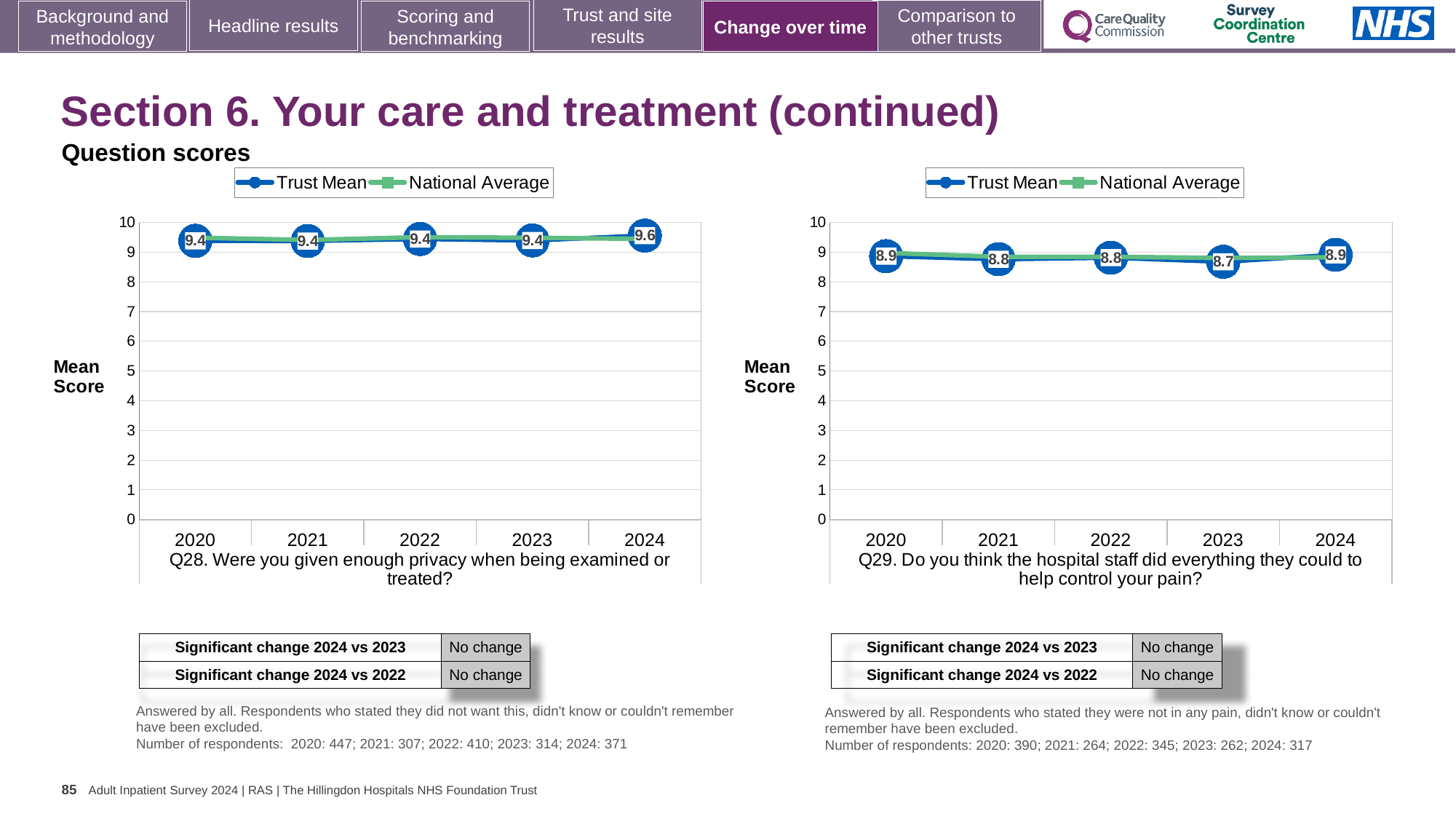
On the Q28 chart (left), what is the Trust Mean score for 2021? 9.4 On the Q28 chart (left), what is the difference between the Trust Mean scores for 2024 and 2023? 0.2 On the Q29 chart (right), what is the Trust Mean score for 2023? 8.7 On the Q29 chart (right), which year has the lowest Trust Mean score? 2023 Is the Trust Mean score for 2022 on the Q29 chart (right) greater or less than 8? greater On the Q28 chart (left), which year has the highest Trust Mean score? 2024 On the Q28 chart (left), what is the Trust Mean score for 2024? 9.6 On the Q29 chart (right), what is the difference between the Trust Mean scores for 2024 and 2023? 0.2 What kind of chart is the Q28 chart (left)? Line chart On the Q29 chart (right), what is the Trust Mean score for 2020? 8.9 How many years are plotted on the Q28 chart (left)? 5 How many series does the legend of the Q29 chart (right) list? 2